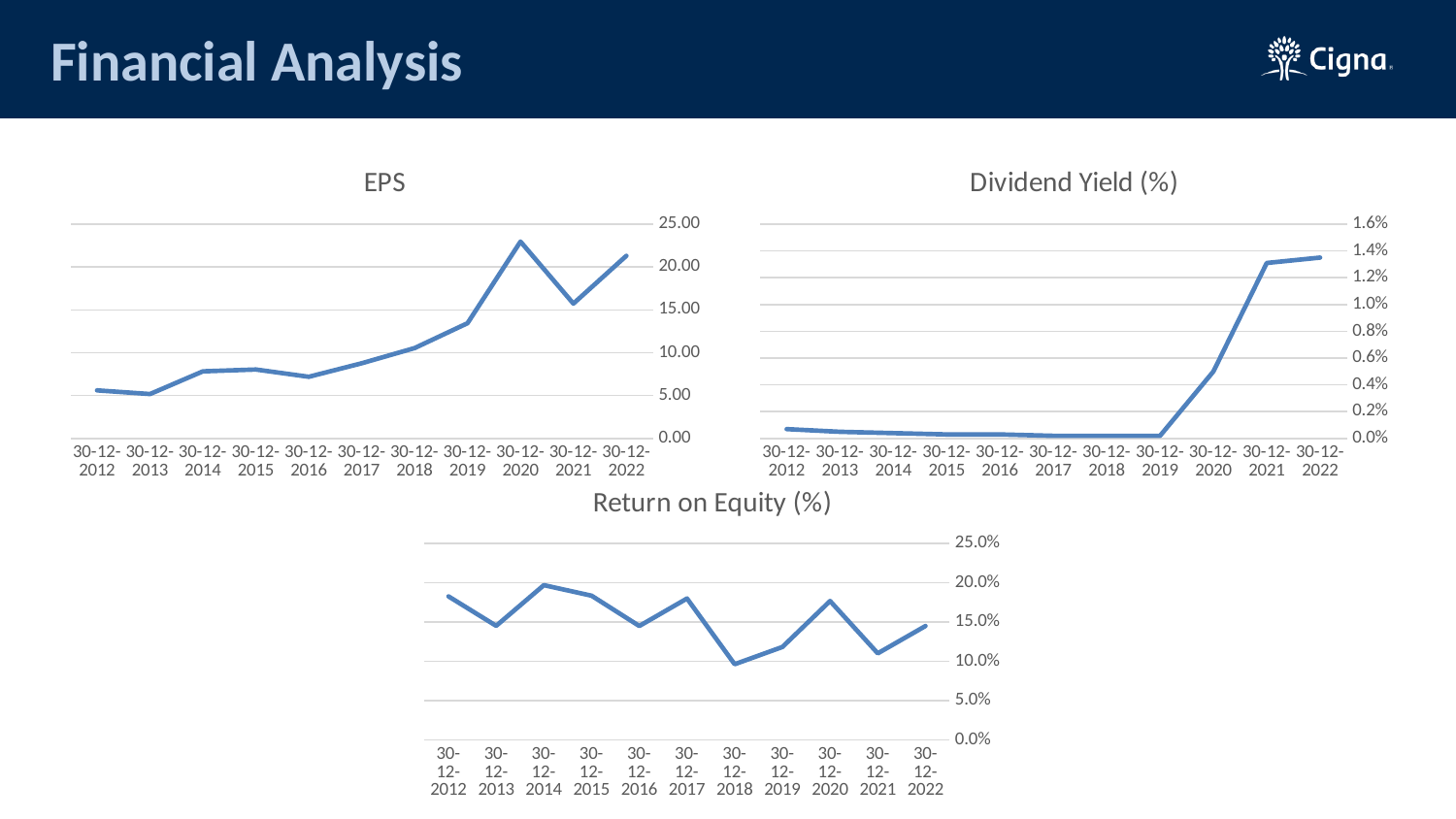
On the Dividend Yield (%) chart, is the value for 30-12-2021 greater or less than 1.0%? greater On the Return on Equity (%) chart, which date has the lowest value? 30-12-2018 On the EPS chart, which date has the highest value? 30-12-2020 How many data points are plotted on the Return on Equity (%) chart? 11 What kind of chart is the EPS chart? line chart On the Return on Equity (%) chart, which is larger, the value for 30-12-2016 or 30-12-2017? 30-12-2017 On the EPS chart, which date has the lowest value? 30-12-2013 On the Return on Equity (%) chart, which date has the highest value? 30-12-2014 On the Dividend Yield (%) chart, is the value for 30-12-2012 greater or less than 0.2%? less On the EPS chart, is the value for 30-12-2019 greater or less than 15.00? less